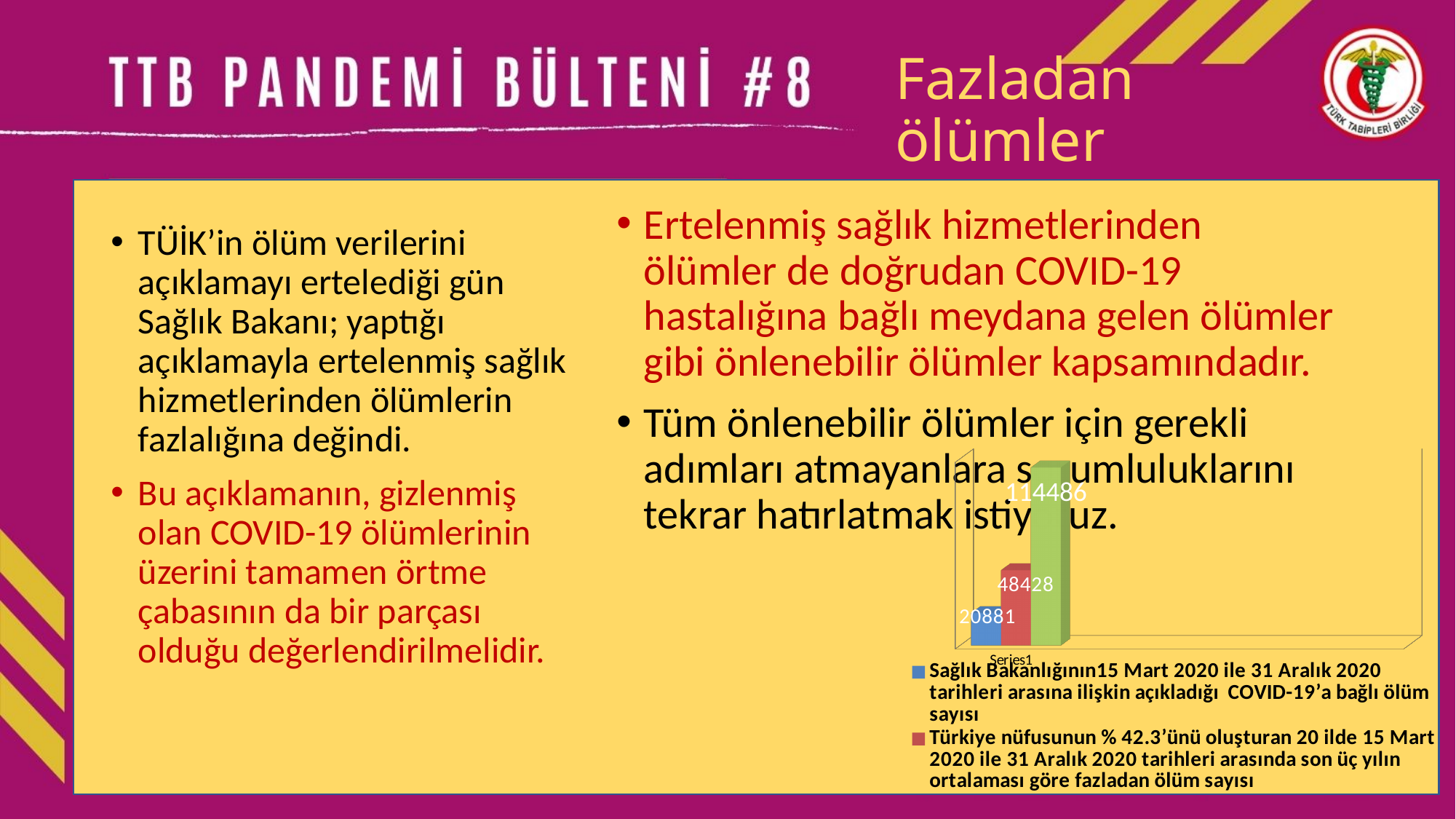
What is the value of the red bar (Türkiye nüfusunun % 42.3'ünü oluşturan 20 ilde fazladan ölüm sayısı)? 48428 What is the value of the green bar in the chart? 114486 What label appears on the category axis below the bars? Series1 Which is larger: the Ministry of Health's announced COVID-19 death count (blue bar) or the excess deaths in the 20 provinces (red bar)? The red bar (excess deaths in the 20 provinces) How much larger is the red bar's value than the blue bar's value? 27547 What is the difference between the green bar's value and the red bar's value? 66058 What kind of chart is shown on the slide? Bar chart What is the value of the tallest bar in the chart? 114486 What is the value of the blue bar (Sağlık Bakanlığının 15 Mart 2020 ile 31 Aralık 2020 tarihleri arasına ilişkin açıkladığı COVID-19'a bağlı ölüm sayısı)? 20881 What is the difference between the green bar's value and the blue bar's value? 93605 How many bars are plotted in the chart? 3 What is the value of the shortest bar in the chart? 20881